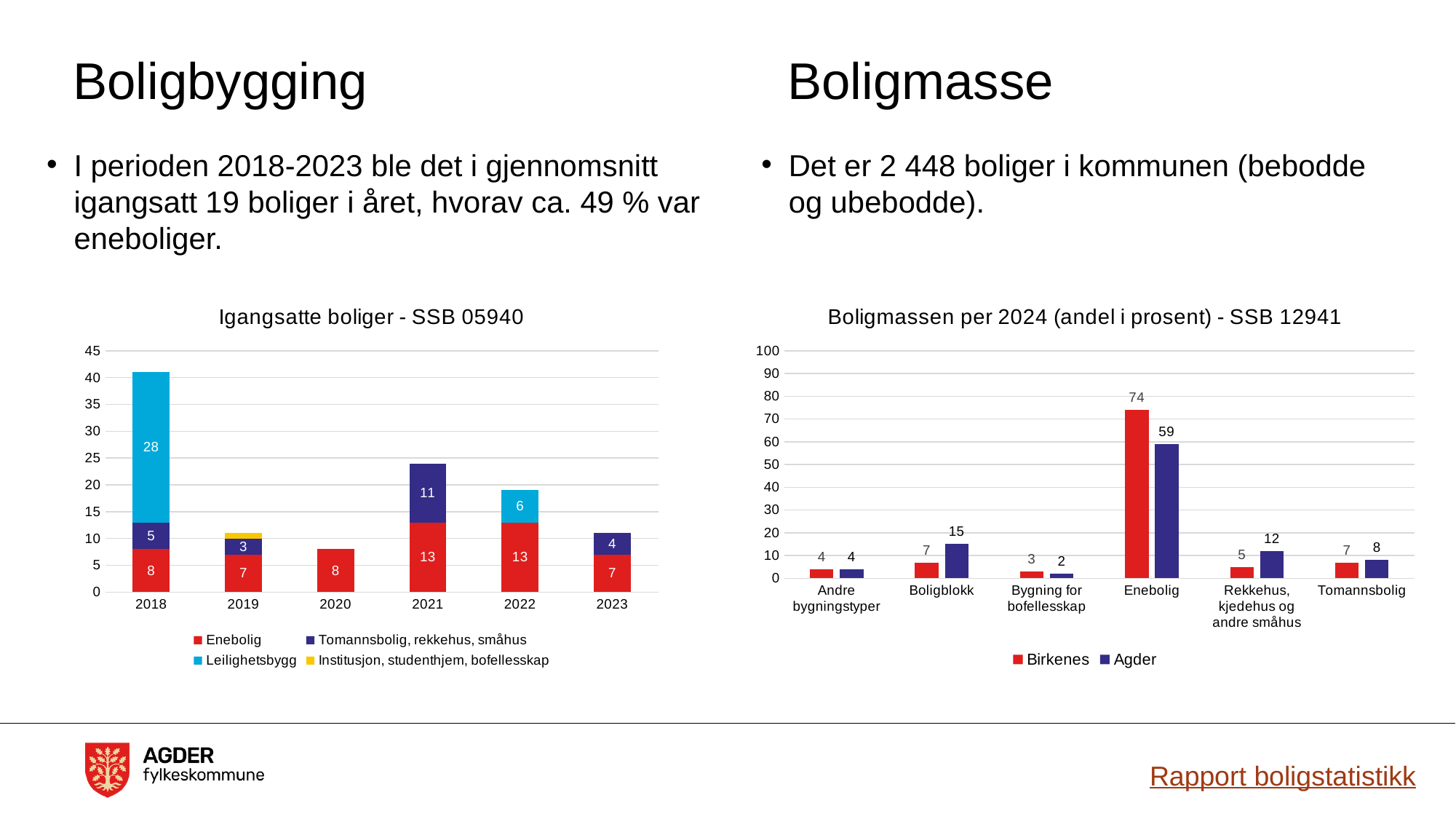
In the 'Igangsatte boliger - SSB 05940' chart, what is the total of the stacked bar for 2018? 41 In the 'Igangsatte boliger - SSB 05940' chart, how many years are shown on the x axis? 6 In the 'Boligmassen per 2024 (andel i prosent) - SSB 12941' chart, which category has the highest value for Birkenes? Enebolig In the 'Boligmassen per 2024 (andel i prosent) - SSB 12941' chart, what is the difference between Birkenes and Agder for Enebolig? 15 In the 'Igangsatte boliger - SSB 05940' chart, how many series does the legend list? 4 In the 'Boligmassen per 2024 (andel i prosent) - SSB 12941' chart, which is larger for Rekkehus, kjedehus og andre småhus: Birkenes or Agder? Agder In the 'Igangsatte boliger - SSB 05940' chart, what is the value for Enebolig in 2021? 13 In the 'Boligmassen per 2024 (andel i prosent) - SSB 12941' chart, what is the value for Agder for Boligblokk? 15 In the 'Igangsatte boliger - SSB 05940' chart, what is the total of the stacked bar for 2021? 24 In the 'Igangsatte boliger - SSB 05940' chart, what is the value for Leilighetsbygg in 2018? 28 In the 'Boligmassen per 2024 (andel i prosent) - SSB 12941' chart, what is the value for Birkenes for Enebolig? 74 What kind of chart is 'Boligmassen per 2024 (andel i prosent) - SSB 12941'? Bar chart